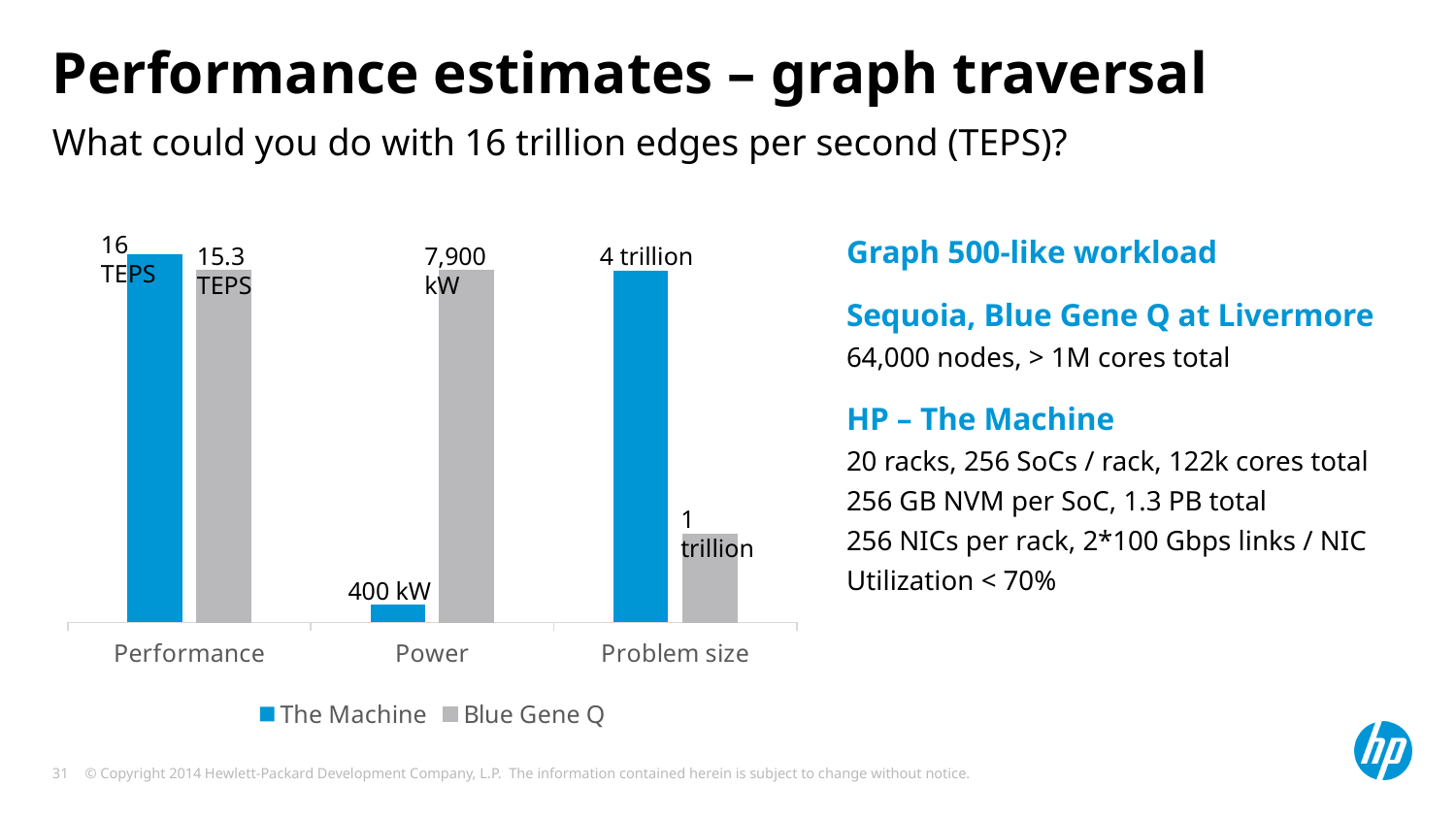
What is the problem size shown for The Machine? 4 trillion What kind of chart is shown on the slide? Bar chart Which system has the higher power value, The Machine or Blue Gene Q? Blue Gene Q What is the difference in power between Blue Gene Q and The Machine? 7,500 kW What is the performance value shown for The Machine? 16 TEPS What is the power value shown for The Machine? 400 kW What is the problem size shown for Blue Gene Q? 1 trillion What is the performance value shown for Blue Gene Q? 15.3 TEPS How many series does the chart legend list? 2 Which system has the larger problem size, The Machine or Blue Gene Q? The Machine How many categories are shown on the x axis of the chart? 3 What is the power value shown for Blue Gene Q? 7,900 kW